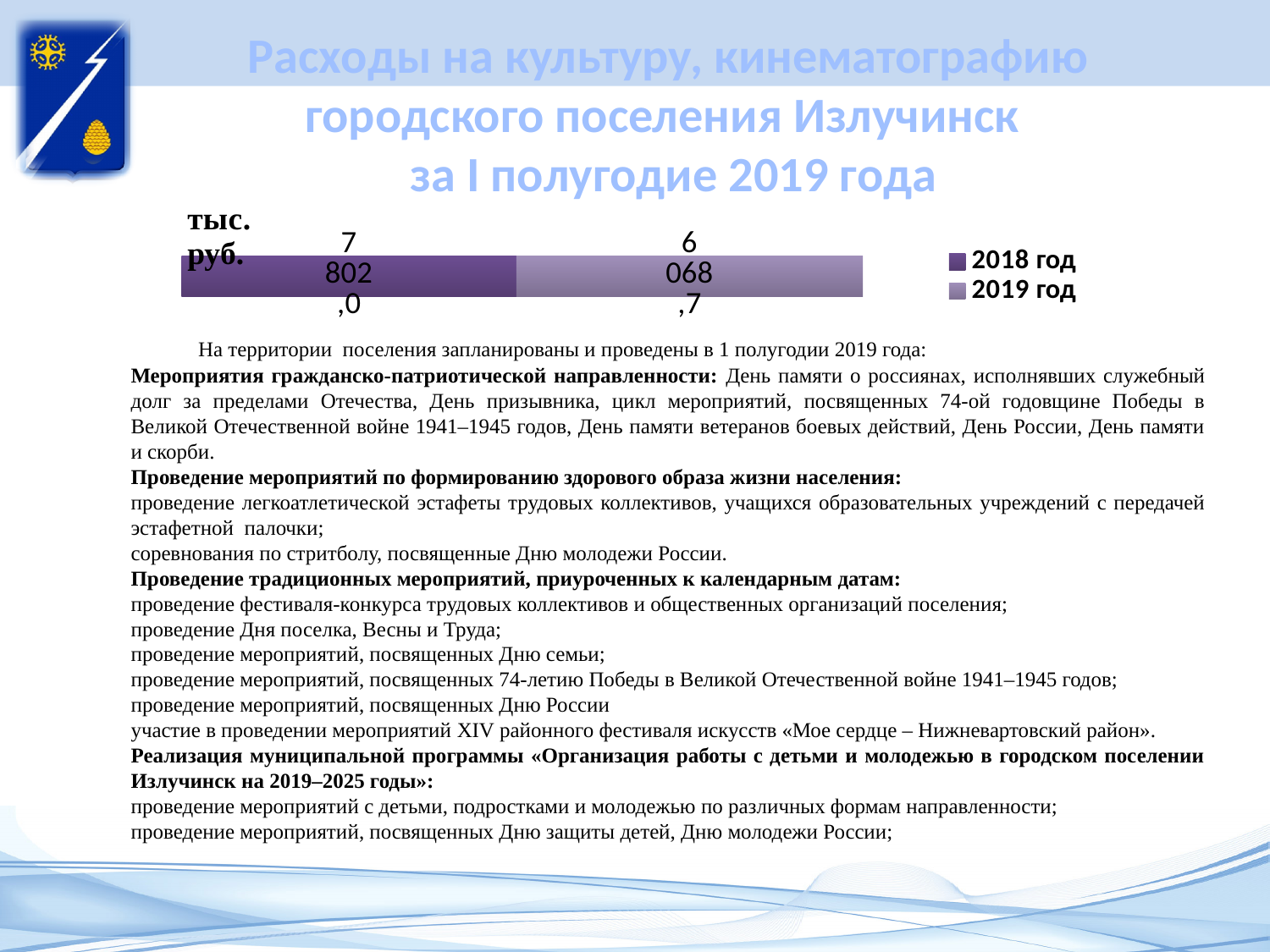
Which year has the larger value, 2018 год or 2019 год? 2018 год Which series has the lowest value in the chart? 2019 год What is the value for 2019 год in the chart? 6 068,7 Which legend entry is shown in the darker purple colour? 2018 год What is the difference between the values for 2018 год and 2019 год? 1 733,3 What is the value for 2018 год in the chart? 7 802,0 Which series has the highest value in the chart? 2018 год What is the total of the two segments in the stacked bar? 13 870,7 What kind of chart is shown on the slide? bar chart Is the value for 2019 год greater or less than 7 000? less How many series does the legend list? 2 What unit is shown next to the chart? тыс. руб.